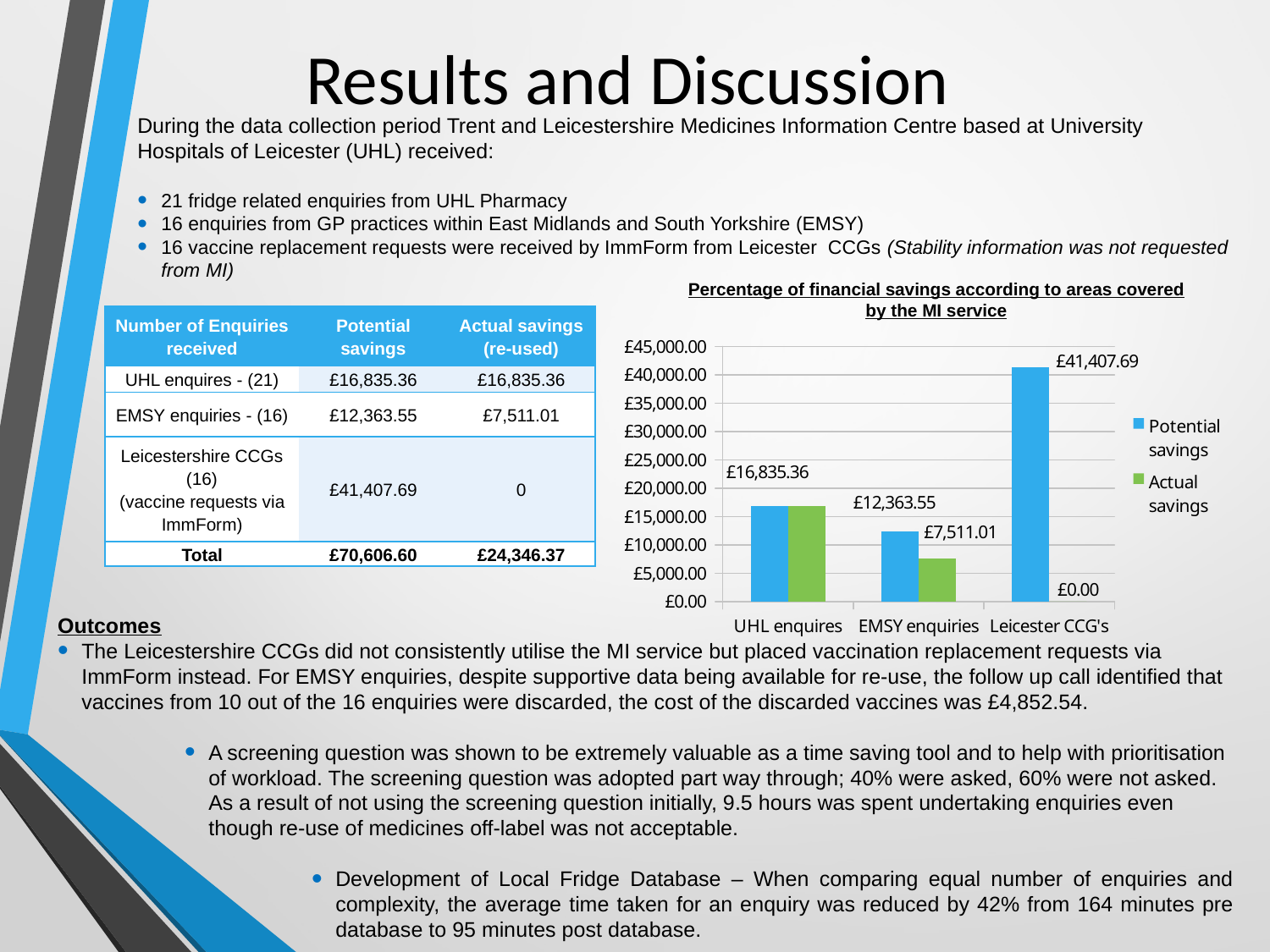
Which category has the lowest actual savings in the chart? Leicester CCG's What kind of chart is shown on the slide? Bar chart Is the potential savings value for Leicester CCG's greater or less than £40,000.00? greater Which category has the highest potential savings in the chart? Leicester CCG's What is the potential savings value for Leicester CCG's in the chart? £41,407.69 What is the potential savings value for EMSY enquiries in the chart? £12,363.55 What is the actual savings value for Leicester CCG's in the chart? £0.00 In the chart, which is larger: the potential savings for UHL enquires or the potential savings for EMSY enquiries? UHL enquires How many categories are shown on the x axis of the chart? 3 What is the difference between potential savings and actual savings for EMSY enquiries in the chart? £4,852.54 What is the actual savings value for EMSY enquiries in the chart? £7,511.01 How many series does the chart's legend list? 2